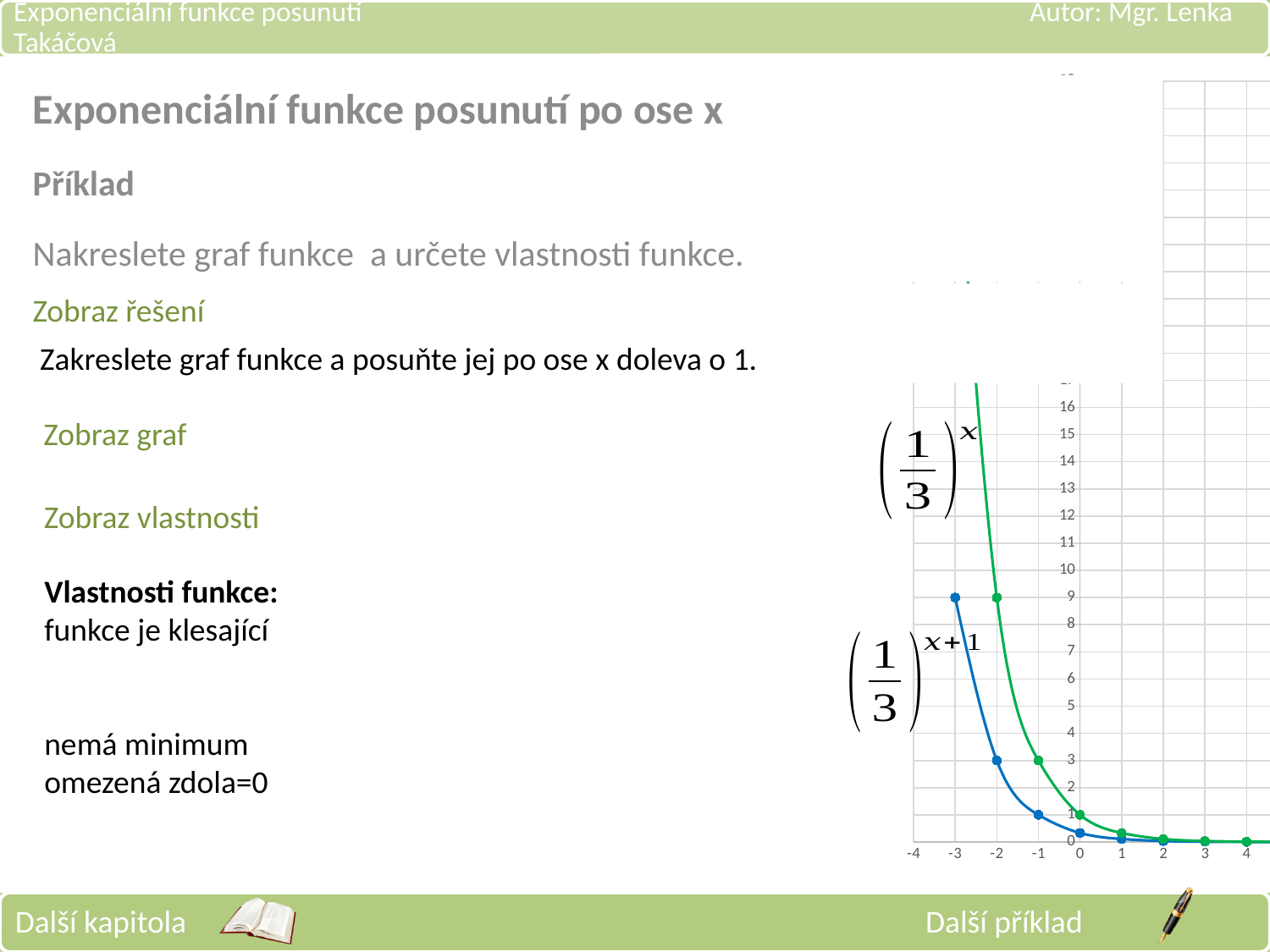
What is the value of the blue curve (1/3)^(x+1) at x = -3? 9 What is the value of the green curve (1/3)^x at x = -2? 9 What is the value of the green curve (1/3)^x at x = -1? 3 Do the values of the curves rise or fall as x increases? fall What kind of chart is shown on the slide? line chart How many curves are plotted on the chart? 2 Is the value of the green curve at x = -3 greater or less than 16? greater What is the value of the blue curve (1/3)^(x+1) at x = -2? 3 At x = -2, which curve has the higher value, the green one or the blue one? green What colour is the curve labelled (1/3)^x? green Is the value of the blue curve at x = 0 greater or less than 1? less What is the difference between the green curve and the blue curve at x = -2? 6